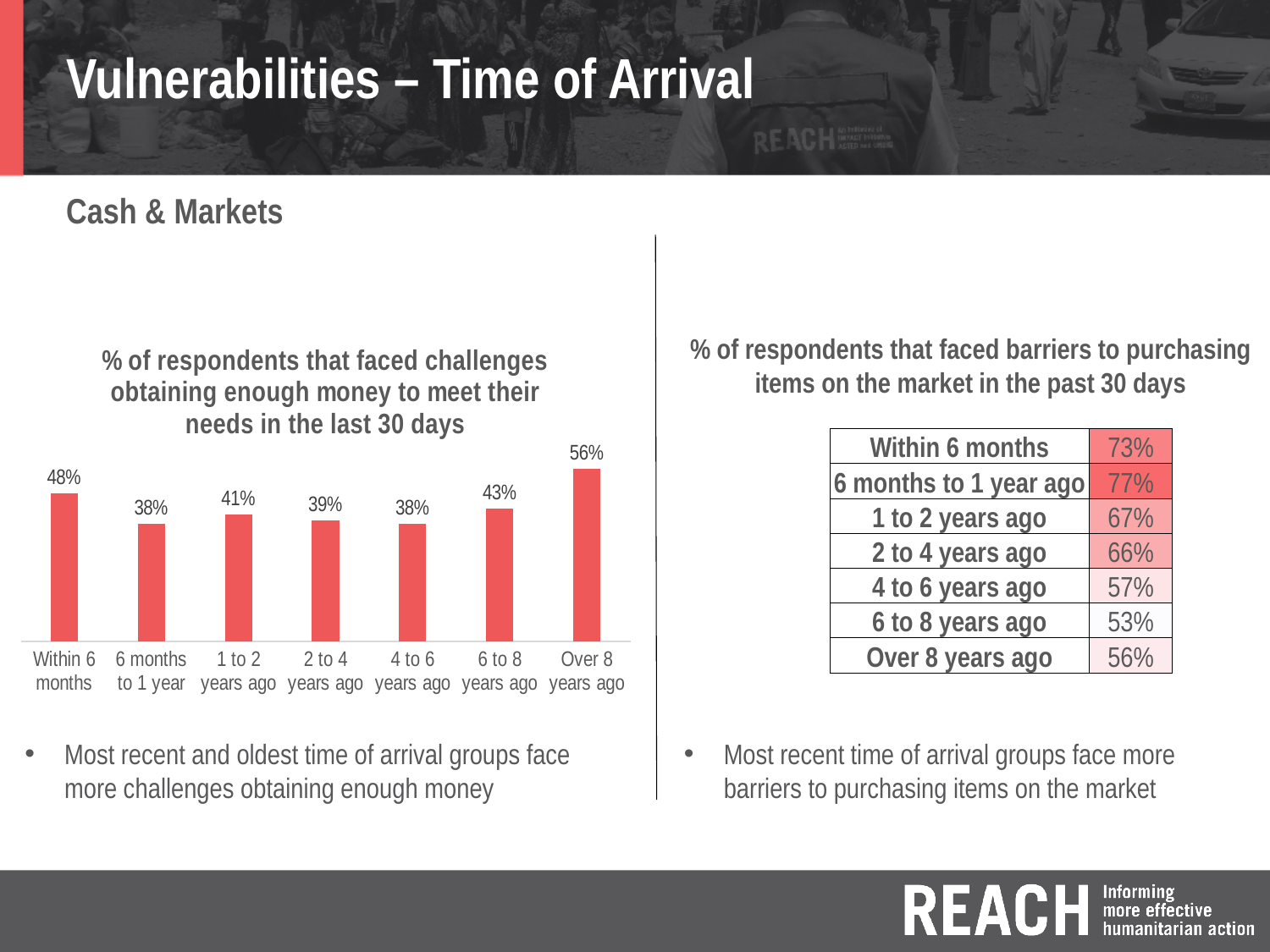
What is the lowest value shown in the bar chart? 38% In the bar chart, what is the value for '1 to 2 years ago'? 41% In the bar chart, which is larger: the value for 'Within 6 months' or the value for 'Over 8 years ago'? Over 8 years ago In the bar chart, what is the difference between the values for 'Within 6 months' and '6 months to 1 year'? 10 percentage points In the bar chart, what is the value for '2 to 4 years ago'? 39% In the bar chart, what is the difference between the values for 'Over 8 years ago' and 'Within 6 months'? 8 percentage points Which time of arrival group has the highest value in the bar chart? Over 8 years ago What type of chart is used to show the % of respondents that faced challenges obtaining enough money? Bar chart What is the value for 'Within 6 months' in the chart '% of respondents that faced challenges obtaining enough money to meet their needs in the last 30 days'? 48% In the bar chart, what percentage of respondents who arrived 6 to 8 years ago faced challenges obtaining enough money? 43% How many time of arrival categories are shown in the bar chart? 7 What is the title of the bar chart on the left of the slide? % of respondents that faced challenges obtaining enough money to meet their needs in the last 30 days